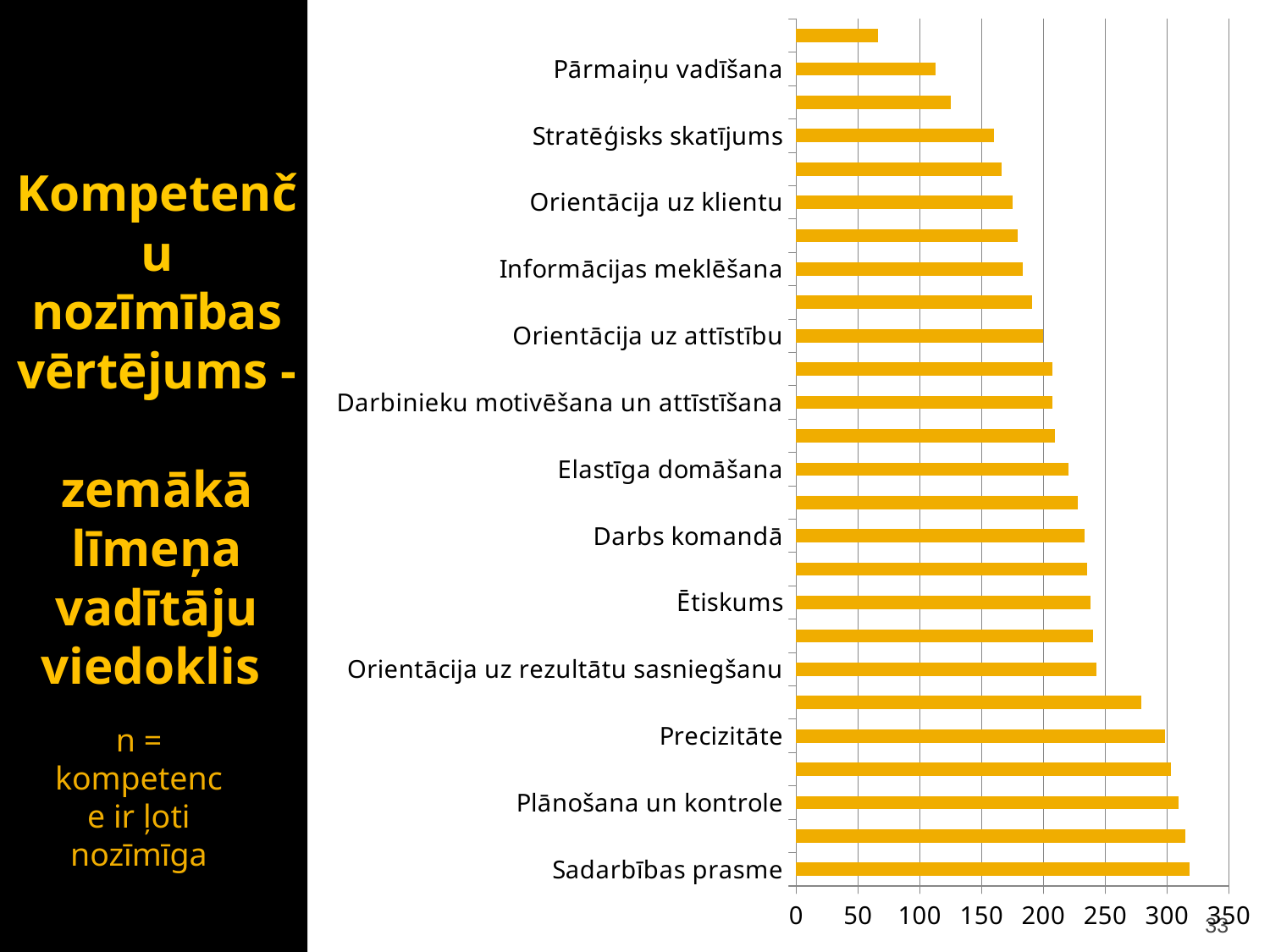
Is the value for Orientācija uz klientu greater or less than 200? less Which is larger, the value for Darbs komandā or the value for Stratēģisks skatījums? Darbs komandā Is the value for Sadarbības prasme greater or less than 300? greater Is the value for Ētiskums greater or less than 250? less Which is larger, the value for Sadarbības prasme or the value for Pārmaiņu vadīšana? Sadarbības prasme What is the highest value shown on the horizontal axis? 350 What kind of chart is shown on the slide? bar chart Which category has the longest bar? Sadarbības prasme